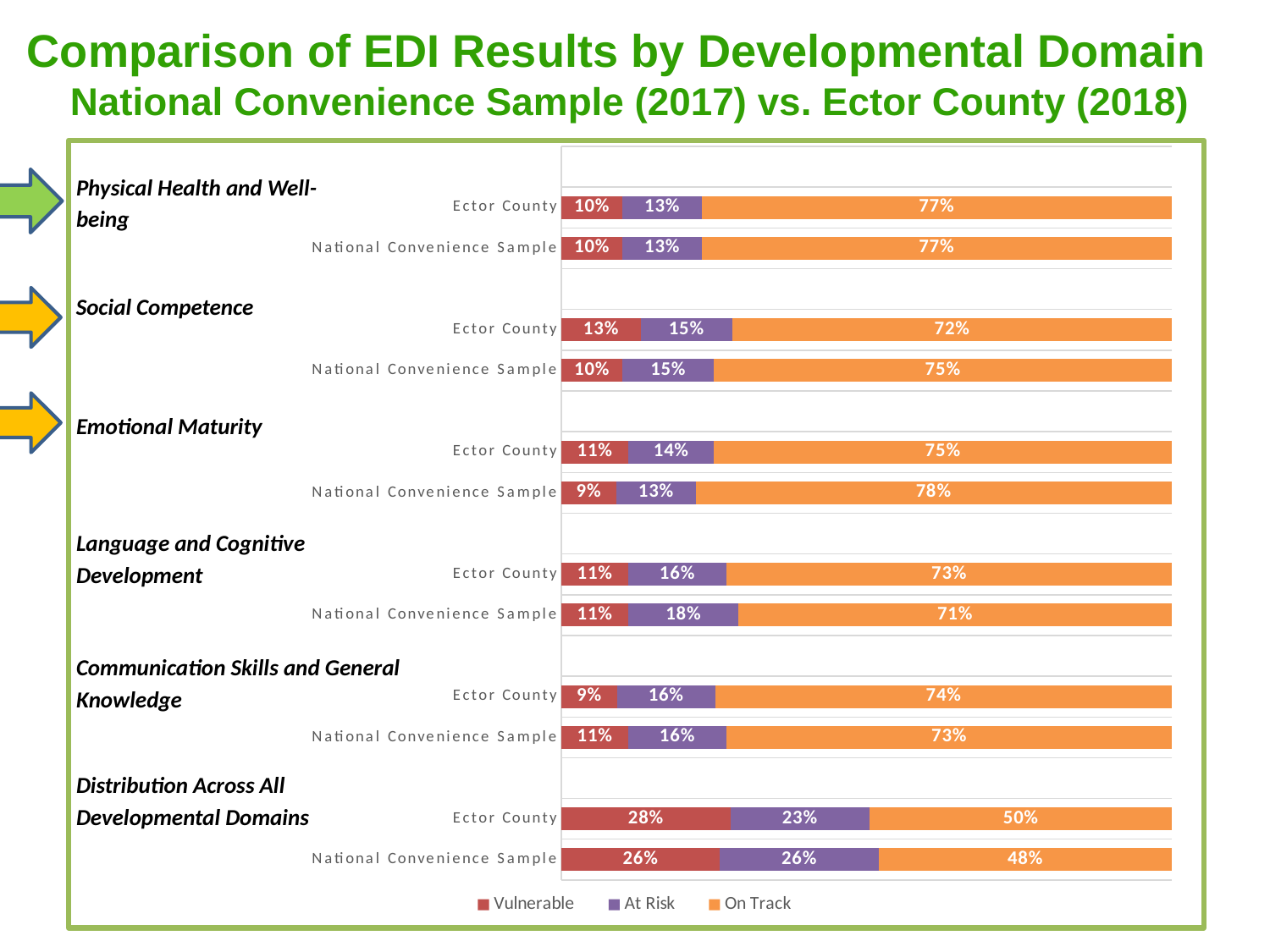
What is the At Risk percentage for the National Convenience Sample in the Language and Cognitive Development domain? 18% What kind of chart is shown on the slide? Stacked bar chart How many developmental domain groups are shown in the chart? 6 How many series does the legend list? 3 What is the difference between the Ector County and National Convenience Sample Vulnerable percentages in the Social Competence domain? 3% Which bar has the highest On Track percentage? National Convenience Sample, Emotional Maturity (78%) In the Communication Skills and General Knowledge domain, which has the higher On Track percentage, Ector County or the National Convenience Sample? Ector County What is the Vulnerable percentage for the National Convenience Sample in the Emotional Maturity domain? 9% Which bar has the lowest On Track percentage? National Convenience Sample, Distribution Across All Developmental Domains (48%) What are the three categories listed in the legend? Vulnerable, At Risk, On Track What is the On Track percentage for Ector County in the Social Competence domain? 72% What is the Vulnerable percentage for Ector County in the Distribution Across All Developmental Domains? 28%